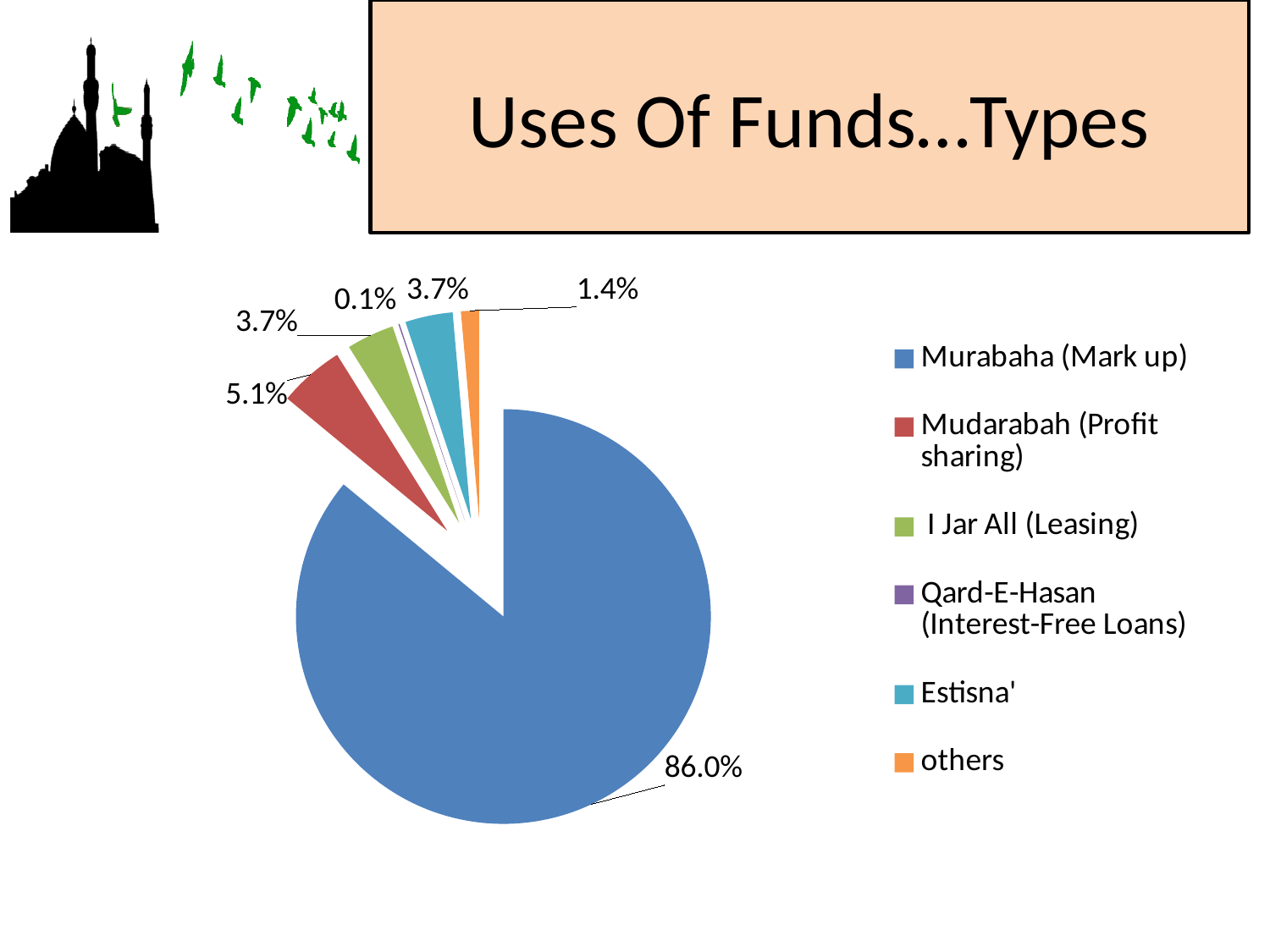
What is the title of the slide containing the chart? Uses Of Funds…Types What is the value for Mudarabah (Profit sharing)? 5.1% Which is larger, the share for Mudarabah (Profit sharing) or the share for I Jar All (Leasing)? Mudarabah (Profit sharing) What kind of chart is shown on the slide? pie chart What is the value for Estisna'? 3.7% Which category has the largest share of the pie? Murabaha (Mark up) How many categories does the legend list? 6 What is the difference between the shares of Mudarabah (Profit sharing) and others? 3.7% What share of the pie does Murabaha (Mark up) represent? 86.0% What is the value for Qard-E-Hasan (Interest-Free Loans)? 0.1% What is the value for others? 1.4% Which category has the smallest share of the pie? Qard-E-Hasan (Interest-Free Loans)